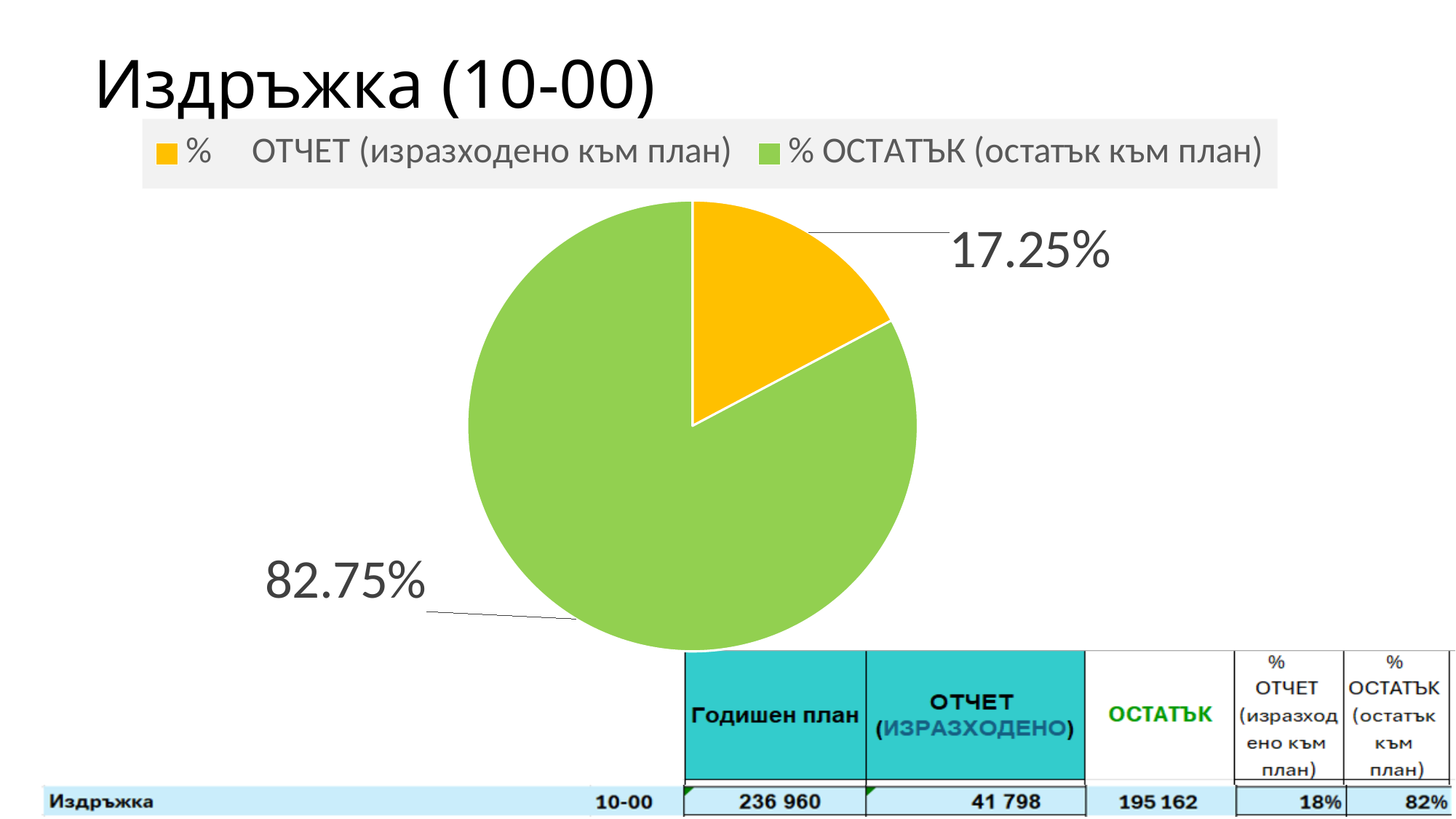
Which slice of the pie chart is the largest? % ОСТАТЪК (остатък към план) What share of the pie does the green slice represent? 82.75% Which is larger in the pie chart: the "% ОТЧЕТ" slice or the "% ОСТАТЪК" slice? % ОСТАТЪК What is the title of the slide containing the pie chart? Издръжка (10-00) How many slices does the pie chart have? 2 Which slice of the pie chart is the smallest? % ОТЧЕТ (изразходено към план) What colour is the "% ОТЧЕТ (изразходено към план)" slice in the pie chart? yellow What is the value of the "% ОСТАТЪК (остатък към план)" slice in the pie chart? 82.75% What kind of chart is shown on the slide? pie chart What is the difference between the "% ОСТАТЪК" slice and the "% ОТЧЕТ" slice in the pie chart? 65.50% How many entries does the legend of the pie chart list? 2 What is the value of the "% ОТЧЕТ (изразходено към план)" slice in the pie chart? 17.25%